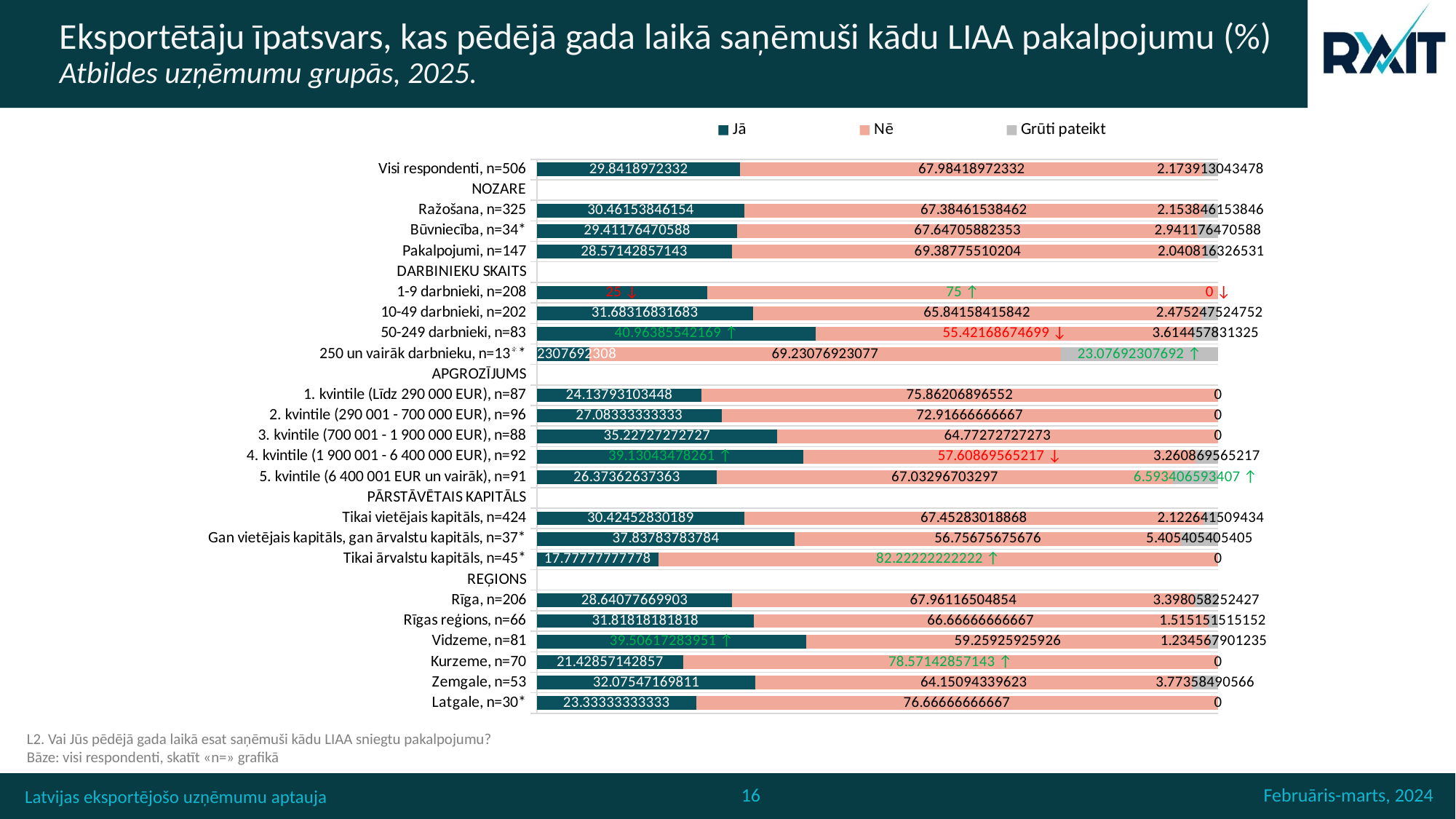
What is the value of the Nē series for Kurzeme, n=70? 78.57142857143 What is the value of the Grūti pateikt series for 250 un vairāk darbnieku, n=13? 23.07692307692 How many categories are listed under the REĢIONS group? 6 What is the value of the Jā series for Visi respondenti, n=506? 29.8418972332 Which category has the highest value in the Nē series? Tikai ārvalstu kapitāls, n=45* What is the value of the Jā series for Vidzeme, n=81? 39.50617283951 Which category has the lowest value in the Jā series? 250 un vairāk darbnieku, n=13 How many series does the legend list? 3 What kind of chart is shown on the slide? Stacked bar chart What are the three legend entries of the chart? Jā, Nē, Grūti pateikt For 1-9 darbnieki, n=208, what is the difference between the Nē value and the Jā value? 50 Which has a larger Jā value: Rīga, n=206 or Vidzeme, n=81? Vidzeme, n=81